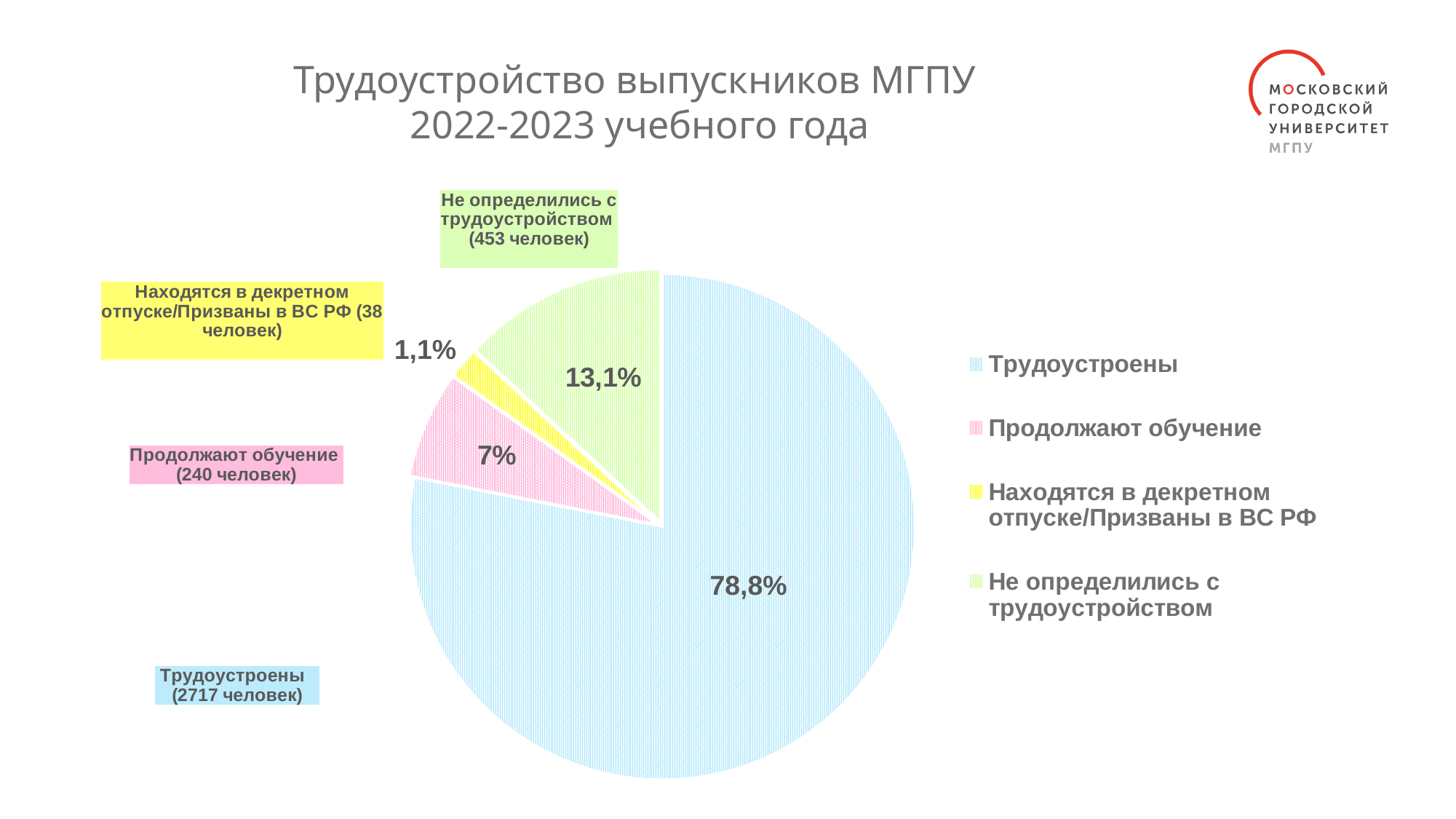
Which category has the largest slice of the pie? Трудоустроены Which category has the smallest slice of the pie? Находятся в декретном отпуске/Призваны в ВС РФ What share of the pie does the slice "Находятся в декретном отпуске/Призваны в ВС РФ" represent? 1,1% How many people are in the "Трудоустроены" category according to the label on the slide? 2717 человек How many people are in the "Продолжают обучение" category according to the label on the slide? 240 человек What share of the pie does the slice "Трудоустроены" represent? 78,8% Which slice is larger: "Не определились с трудоустройством" or "Продолжают обучение"? Не определились с трудоустройством What share of the pie does the slice "Продолжают обучение" represent? 7% What type of chart is shown on the slide? pie chart What is the difference in percentage points between the "Трудоустроены" slice and the "Не определились с трудоустройством" slice? 65,7% How many categories does the legend of the pie chart list? 4